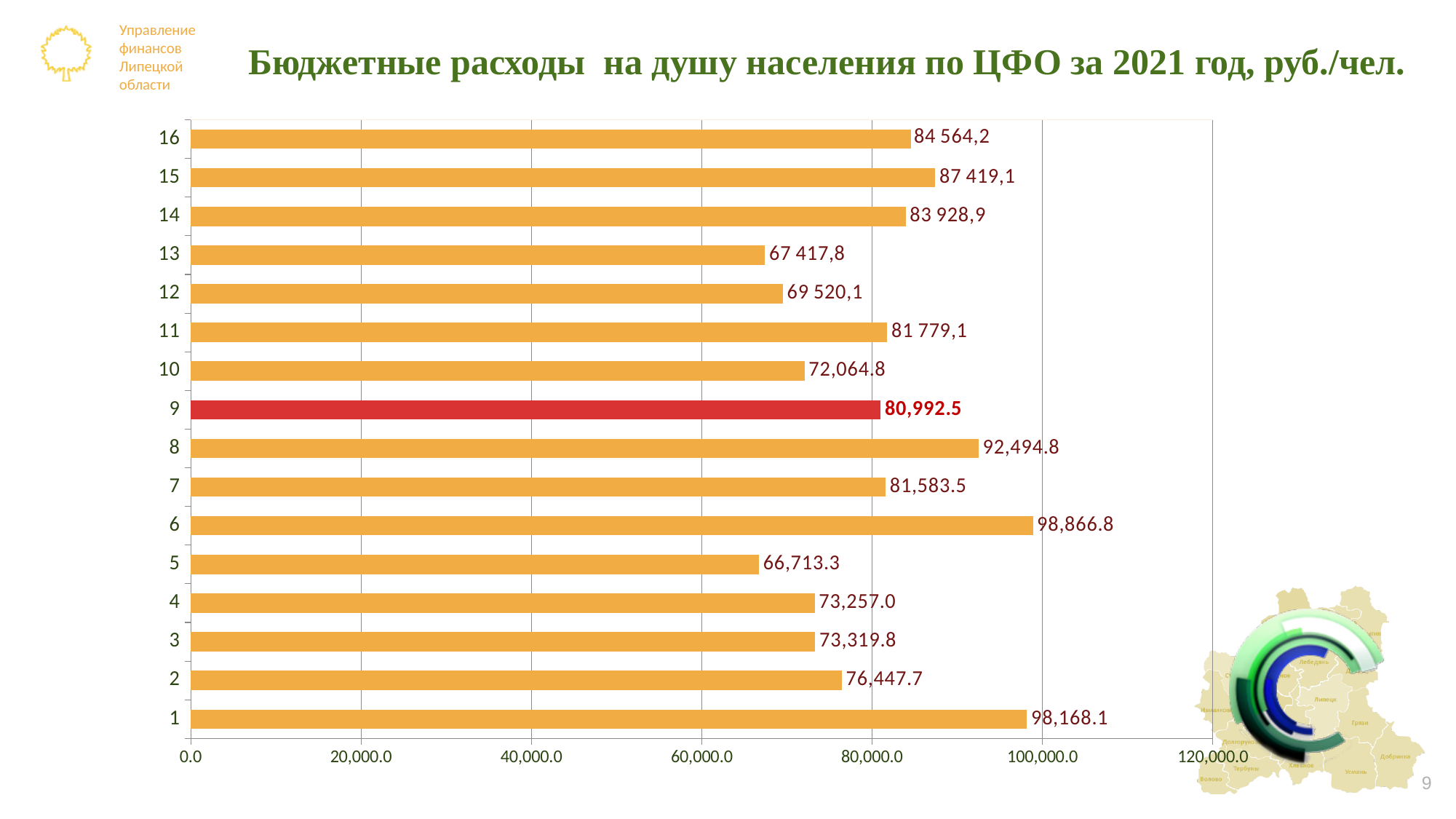
Which category has the highest value? 6 Which category's bar is highlighted in red? 9 What is the difference between the values for category 8 and category 9? 11,502.3 What kind of chart is shown on the slide? bar chart Is the value for category 12 greater or less than 80,000.0? less How many categories are shown on the chart? 16 Which is larger, the value for category 15 or the value for category 14? 15 Which category has the lowest value? 5 What is the value for category 5? 66,713.3 What is the title of the chart? Бюджетные расходы на душу населения по ЦФО за 2021 год, руб./чел. What is the value for category 16? 84 564,2 What is the value for category 9? 80,992.5